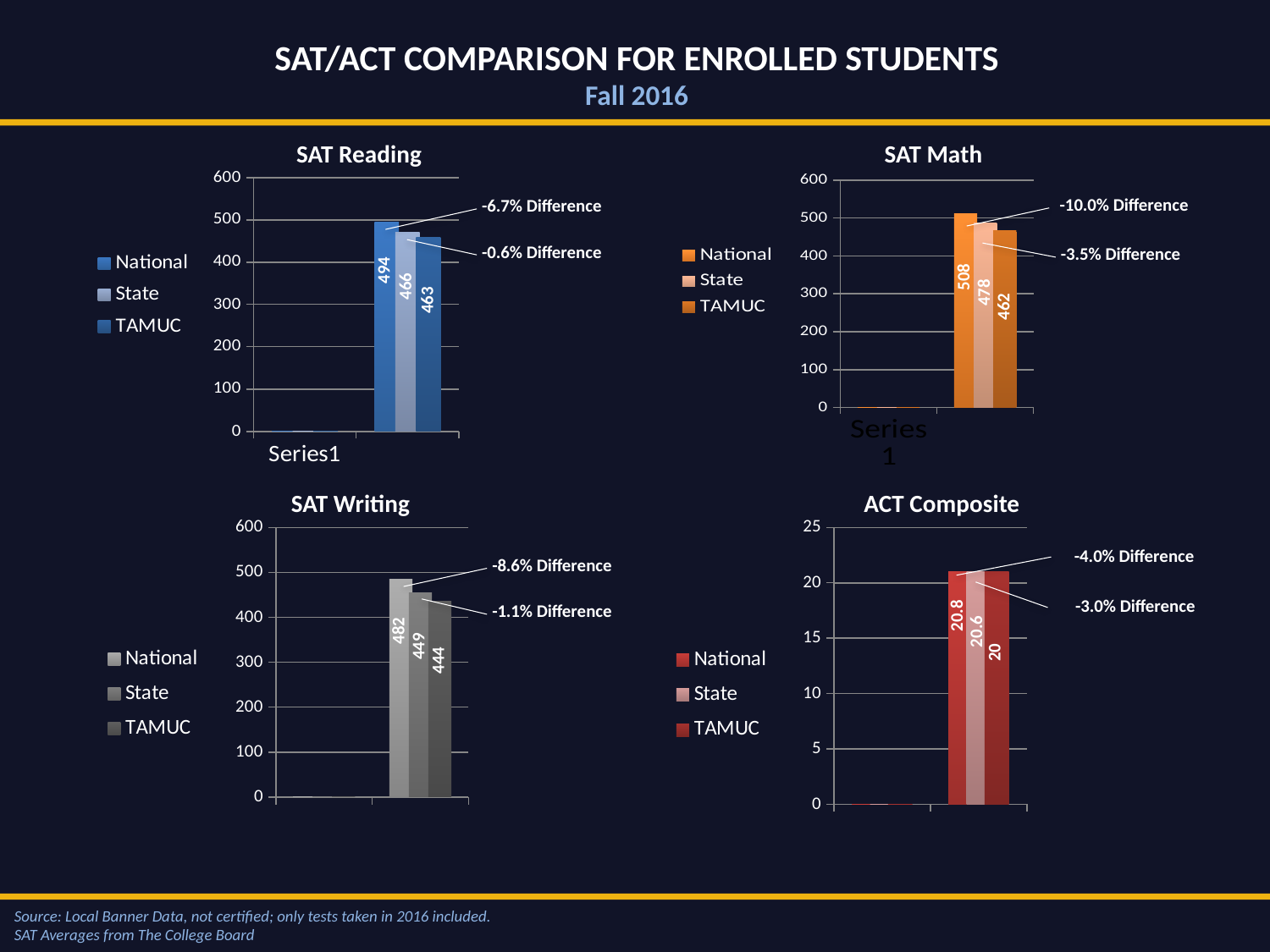
What kind of chart is the SAT Reading chart? Bar chart In the SAT Writing chart, which series has the lowest value? TAMUC In the ACT Composite chart, what is the value for State? 20.6 How many series does the legend of the ACT Composite chart list? 3 In the SAT Math chart, what is the value for TAMUC? 462 In the SAT Reading chart, what is the difference between the National and TAMUC values? 31 In the SAT Math chart, what percentage difference is annotated between National and TAMUC? -10.0% Difference In the SAT Writing chart, what is the value for State? 449 In the SAT Reading chart, what is the value for National? 494 In the SAT Math chart, what is the difference between the State and TAMUC values? 16 In the SAT Math chart, which series has the highest value? National In the SAT Writing chart, is the National value larger or the TAMUC value? National